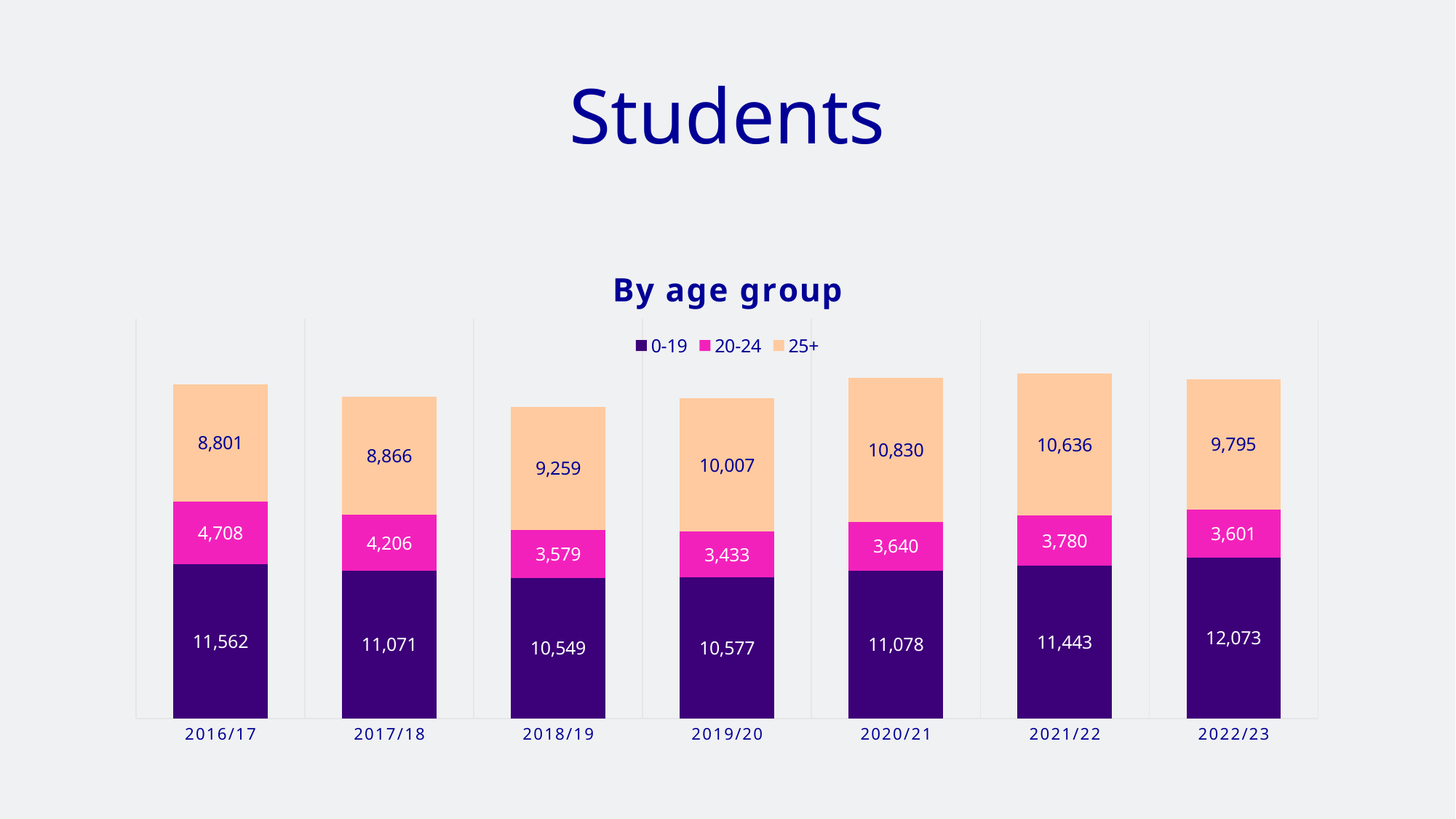
What is the value for the 25+ age group in 2019/20? 10,007 What kind of chart is shown? Stacked bar chart What is the value for the 0-19 age group in 2022/23? 12,073 In which year is the 20-24 age group value lowest? 2019/20 How many series does the legend list? 3 Which is larger, the 20-24 value in 2016/17 or in 2021/22? 2016/17 In which year is the 25+ age group value highest? 2020/21 What is the value for the 20-24 age group in 2017/18? 4,206 In which year is the 0-19 age group value highest? 2022/23 What is the difference between the 25+ values in 2020/21 and 2016/17? 2,029 What is the total of the stacked bar for 2016/17? 25,071 How many years are shown on the x axis? 7